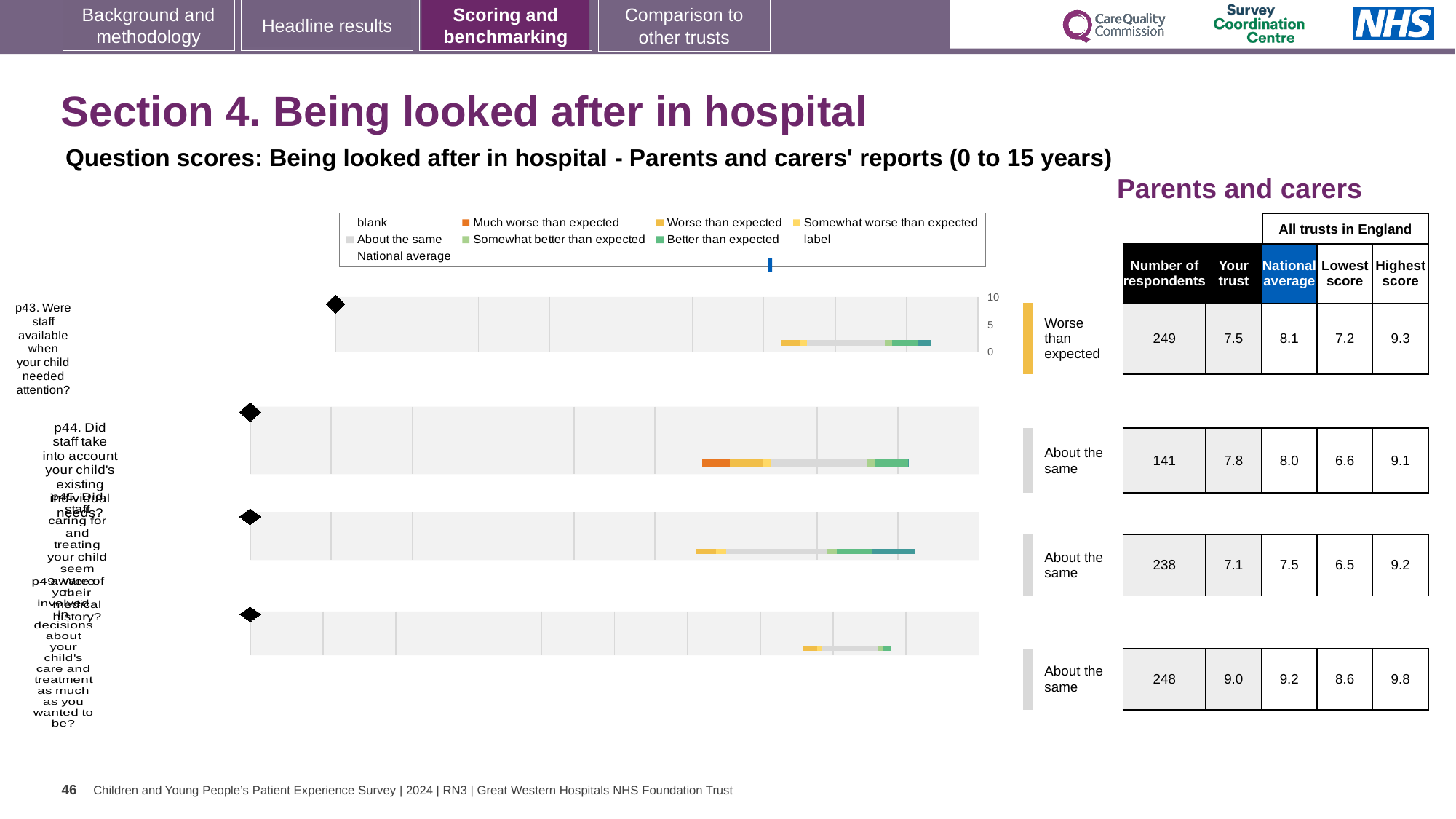
What is the highest score across all trusts in England for question p45 (third row)? 9.2 What is the national average score for question p43 (first row)? 8.1 What benchmark category is shown for question p43 (first row)? Worse than expected For question p44 (second row), which is larger: the 'Your trust' score or the national average? National average How many questions (rows) are plotted in the chart? 4 For question p43 (first row), what is the difference between the highest score and the lowest score across all trusts in England? 2.1 Which question has the highest 'Your trust' score? p49 (fourth row) How many respondents are shown for question p44 (second row)? 141 What is the lowest score across all trusts in England for question p49 (fourth row)? 8.6 What kind of chart is used to show the question scores on this slide? bar chart Which question has the lowest 'Your trust' score? p45 (third row) What is the 'Your trust' score for question p43 (first row)? 7.5